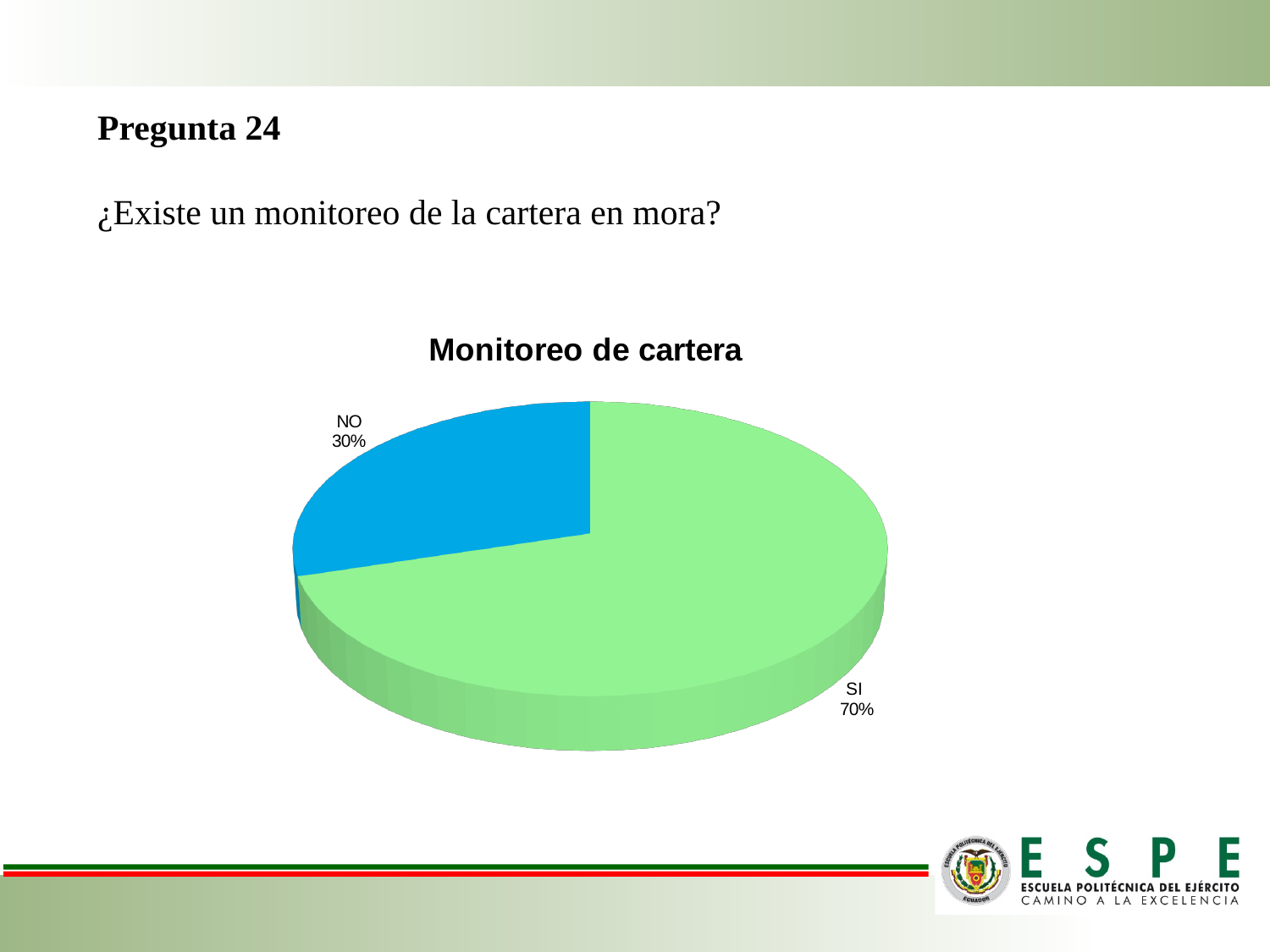
What percentage of the pie is labelled SI? 70% What share of the pie does the NO slice represent? 30% What percentage of the pie is labelled NO? 30% What kind of chart is shown on the slide? pie chart Which slice is larger, SI or NO? SI What is the title of the chart? Monitoreo de cartera What is the difference in percentage points between the SI and NO slices? 40 Which slice of the pie is the smallest? NO What colour is the SI slice? green How many slices does the pie chart have? 2 Which slice of the pie is the largest? SI